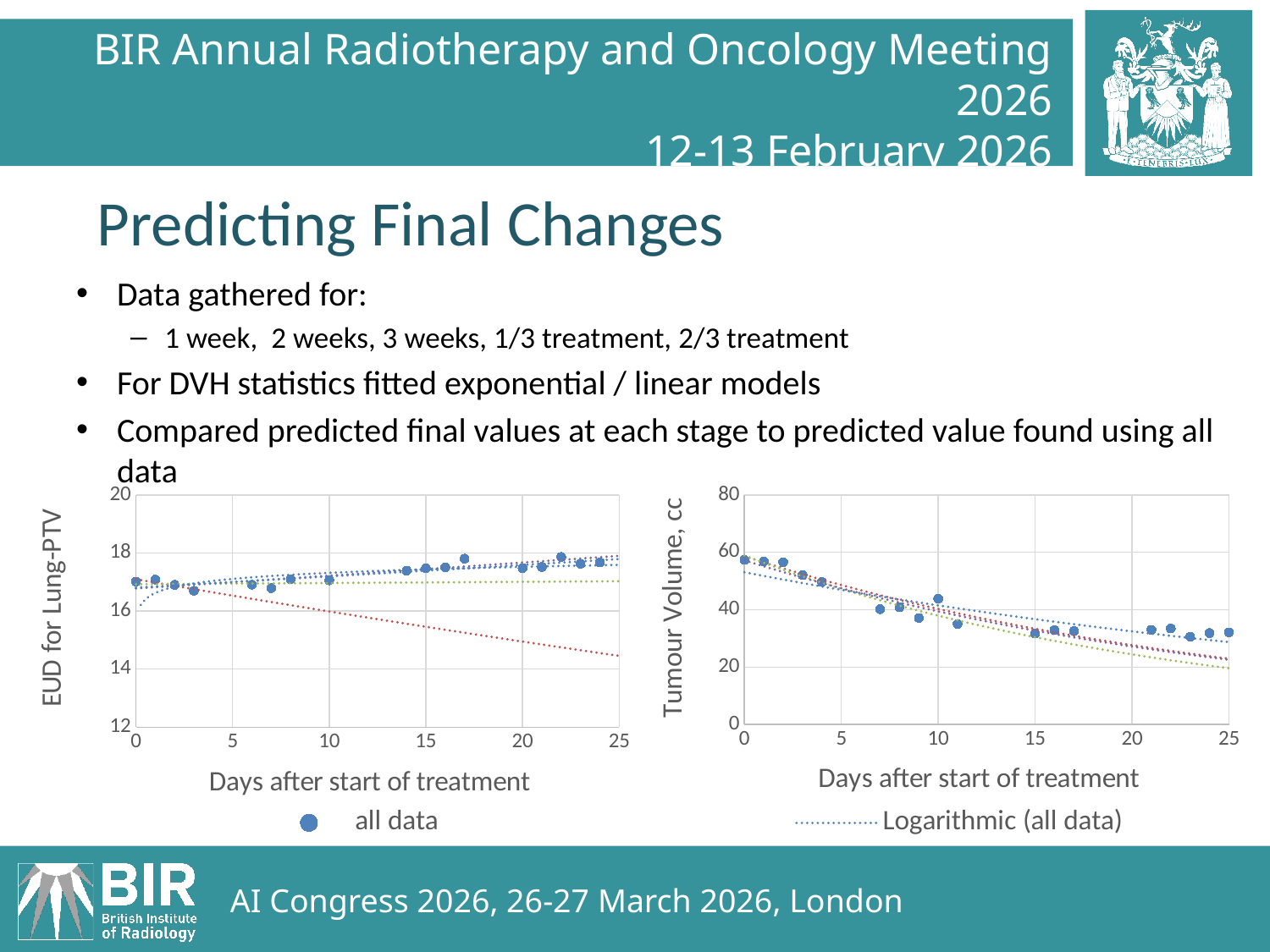
What kind of chart is the right chart (Tumour Volume, cc)? scatter chart In the left chart (EUD for Lung-PTV), is the value at day 0 greater or less than 16? greater What is the maximum value shown on the y axis of the right chart (Tumour Volume, cc)? 80 In the right chart (Tumour Volume, cc), is the value at day 0 greater or less than 40? greater In the right chart (Tumour Volume, cc), do the plotted values rise or fall as days after start of treatment increase? fall In the left chart (EUD for Lung-PTV), is the value at day 22 greater or less than 16? greater What is the y-axis title of the left chart? EUD for Lung-PTV In the left chart (EUD for Lung-PTV), do the plotted values rise or fall overall as days after start of treatment increase? rise What is the x-axis title of the right chart (Tumour Volume, cc)? Days after start of treatment What kind of chart is the left chart (EUD for Lung-PTV)? scatter chart